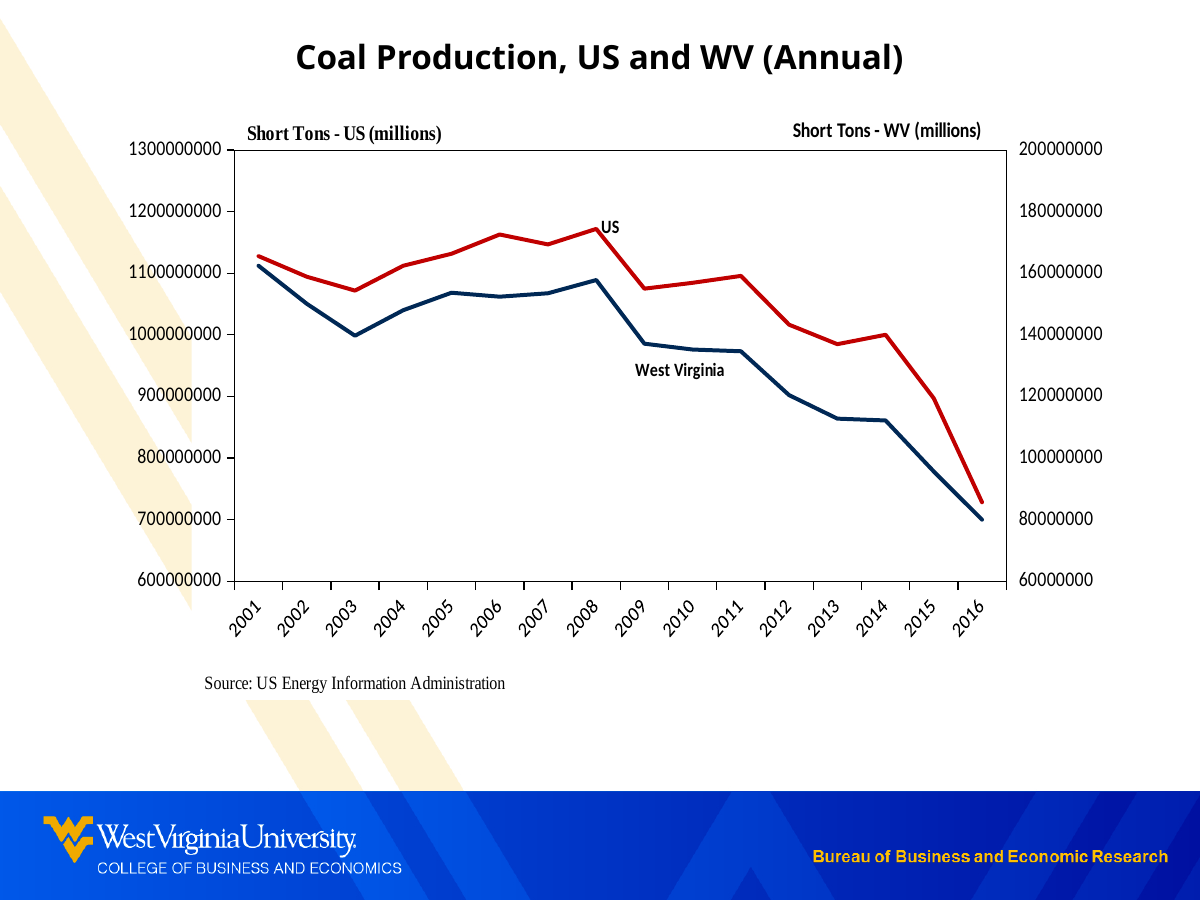
What kind of chart is shown on the slide? line chart What is the title of the chart? Coal Production, US and WV (Annual) What source is cited below the chart? US Energy Information Administration Is the US value for 2016 greater or less than 800000000 on the left axis? less In which year does the US series reach its highest value? 2008 Is the West Virginia value for 2016 greater or less than 100000000 on the right axis? less Overall, do the West Virginia values rise or fall from 2001 to 2016? fall How many series are plotted on the chart? 2 How many years are plotted along the x axis? 16 In which year does the West Virginia series reach its highest value? 2001 Is the US value for 2008 greater or less than 1100000000 on the left axis? greater In which year does the US series reach its lowest value? 2016